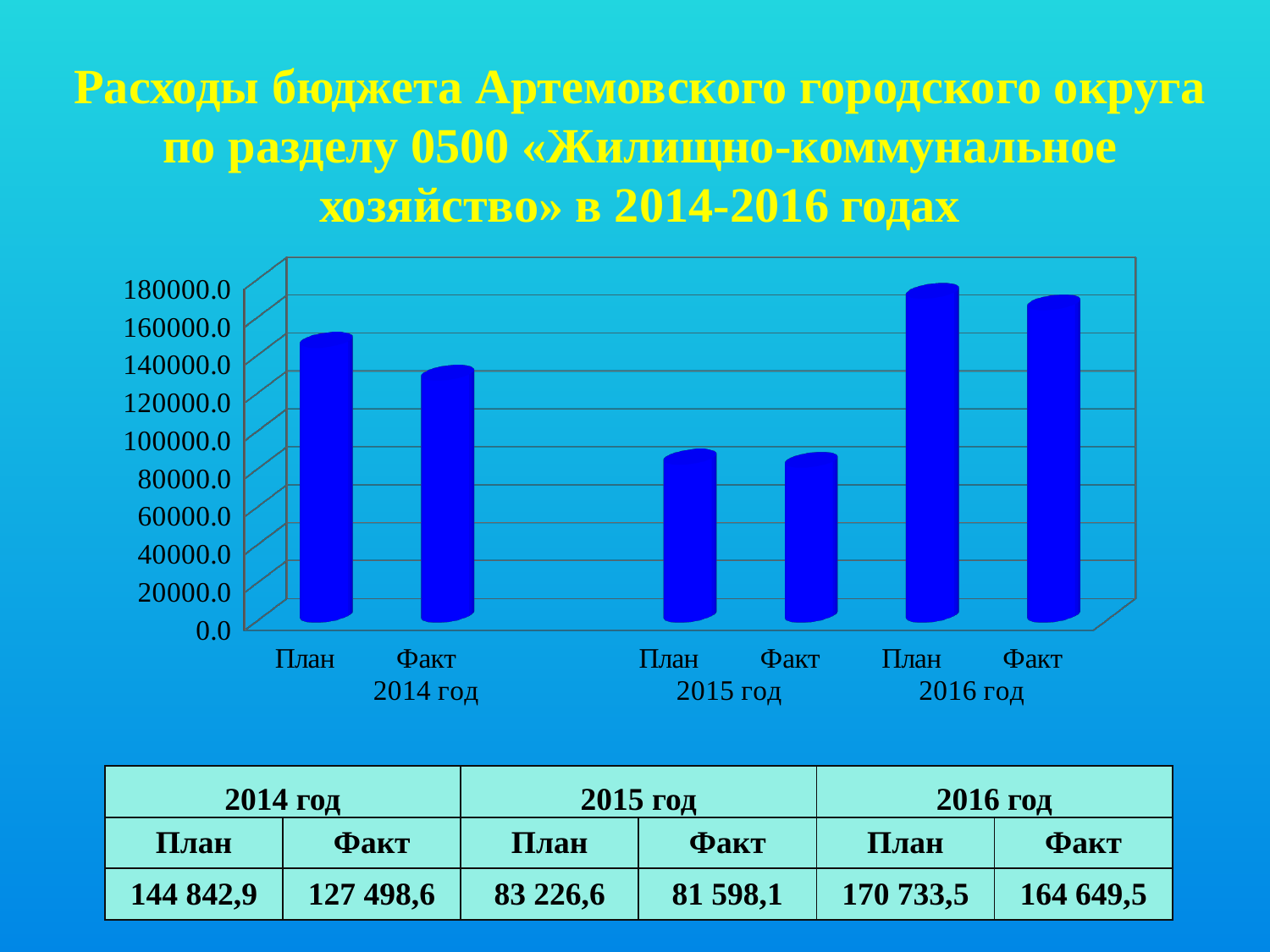
What kind of chart is shown on the slide? bar chart What is the difference between План and Факт for 2014 год? 17 344,3 What is the planned (План) value for 2014 год? 144 842,9 What is the difference between План and Факт for 2016 год? 6 084,0 Is the План value for 2015 год greater or less than 100000.0? less Which is larger, the Факт value for 2014 год or the Факт value for 2016 год? Факт 2016 год How many bars are plotted in the chart? 6 Which bar has the highest value? План 2016 год What is the actual (Факт) value for 2016 год? 164 649,5 Which bar has the lowest value? Факт 2015 год Is the Факт value lower than the План value in every year shown? yes What is the actual (Факт) value for 2015 год? 81 598,1